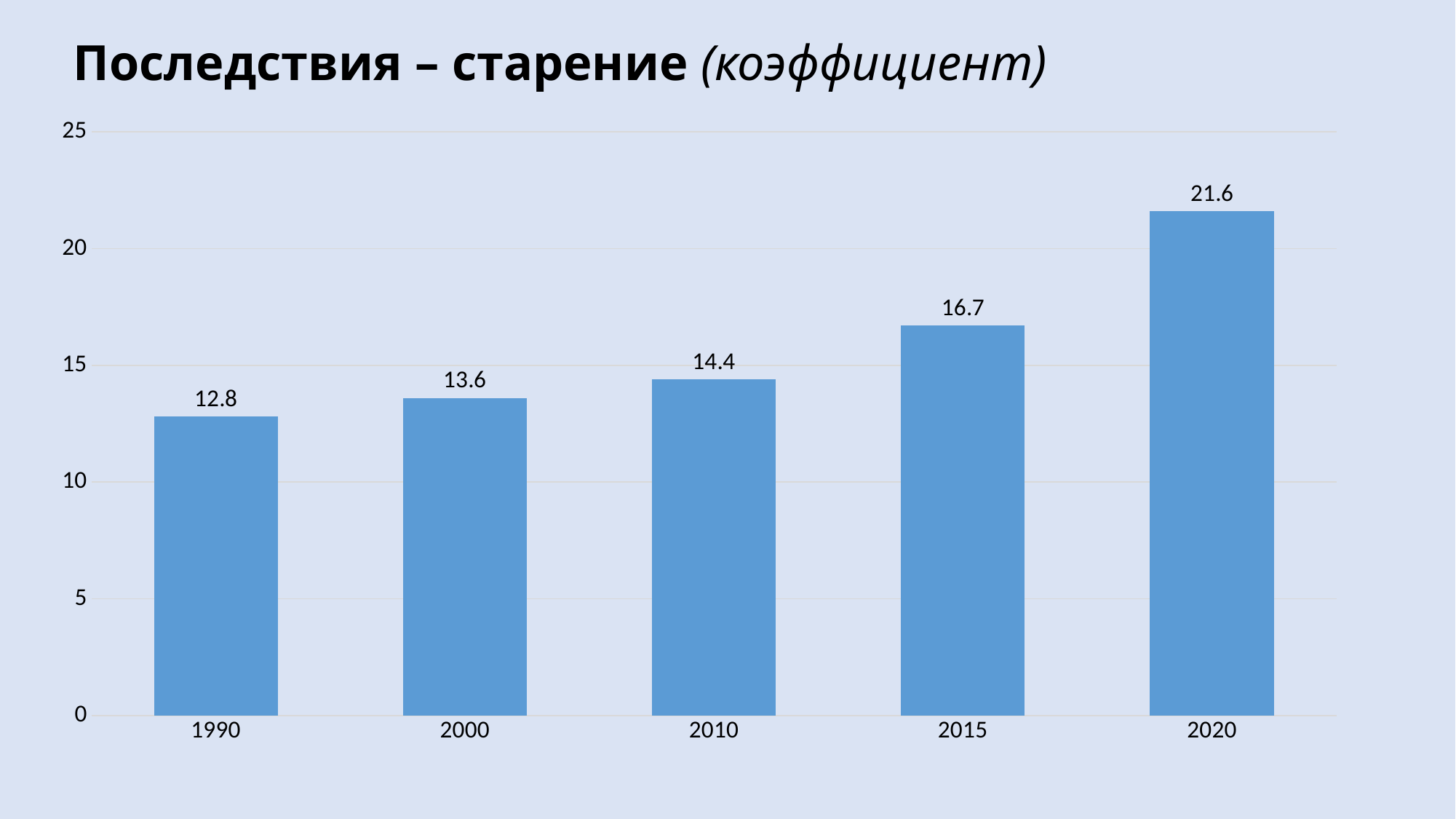
What is the value for 2010? 14.4 Is the value for 2015 greater or less than 15? greater How many years are shown on the chart? 5 Which is larger, the value for 2015 or the value for 2010? 2015 Do the values rise or fall from 1990 to 2020? rise What is the difference between the values for 2000 and 1990? 0.8 What is the difference between the values for 2020 and 2015? 4.9 What is the value for 1990? 12.8 What is the value for 2020? 21.6 Which year has the lowest value? 1990 What kind of chart is shown on the slide? bar chart Which year has the highest value? 2020